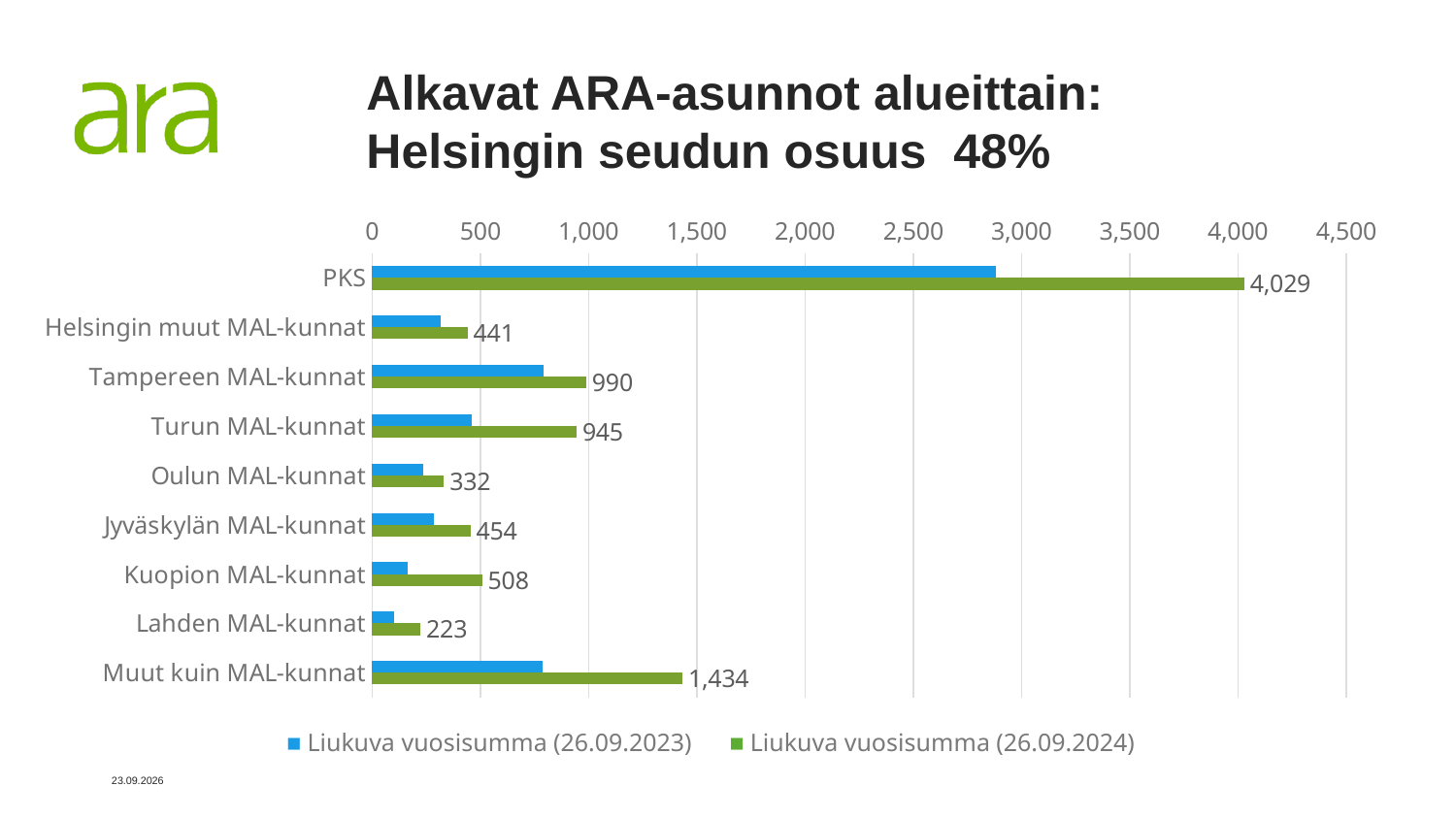
What is the value for PKS in the Liukuva vuosisumma (26.09.2024) series? 4,029 How many series does the legend list? 2 What is the value for Oulun MAL-kunnat in the Liukuva vuosisumma (26.09.2024) series? 332 How many categories are shown on the chart? 9 What is the value for Muut kuin MAL-kunnat in the Liukuva vuosisumma (26.09.2024) series? 1,434 Is the value for PKS in the Liukuva vuosisumma (26.09.2023) series greater or less than 2,500? greater Which category has the highest value in the Liukuva vuosisumma (26.09.2024) series? PKS What kind of chart is shown on the slide? bar chart What is the difference between Tampereen MAL-kunnat and Turun MAL-kunnat in the Liukuva vuosisumma (26.09.2024) series? 45 Is the value for Tampereen MAL-kunnat in the Liukuva vuosisumma (26.09.2023) series greater or less than 1,000? less Which is larger in the Liukuva vuosisumma (26.09.2024) series: Kuopion MAL-kunnat or Jyväskylän MAL-kunnat? Kuopion MAL-kunnat Which category has the lowest value in the Liukuva vuosisumma (26.09.2024) series? Lahden MAL-kunnat